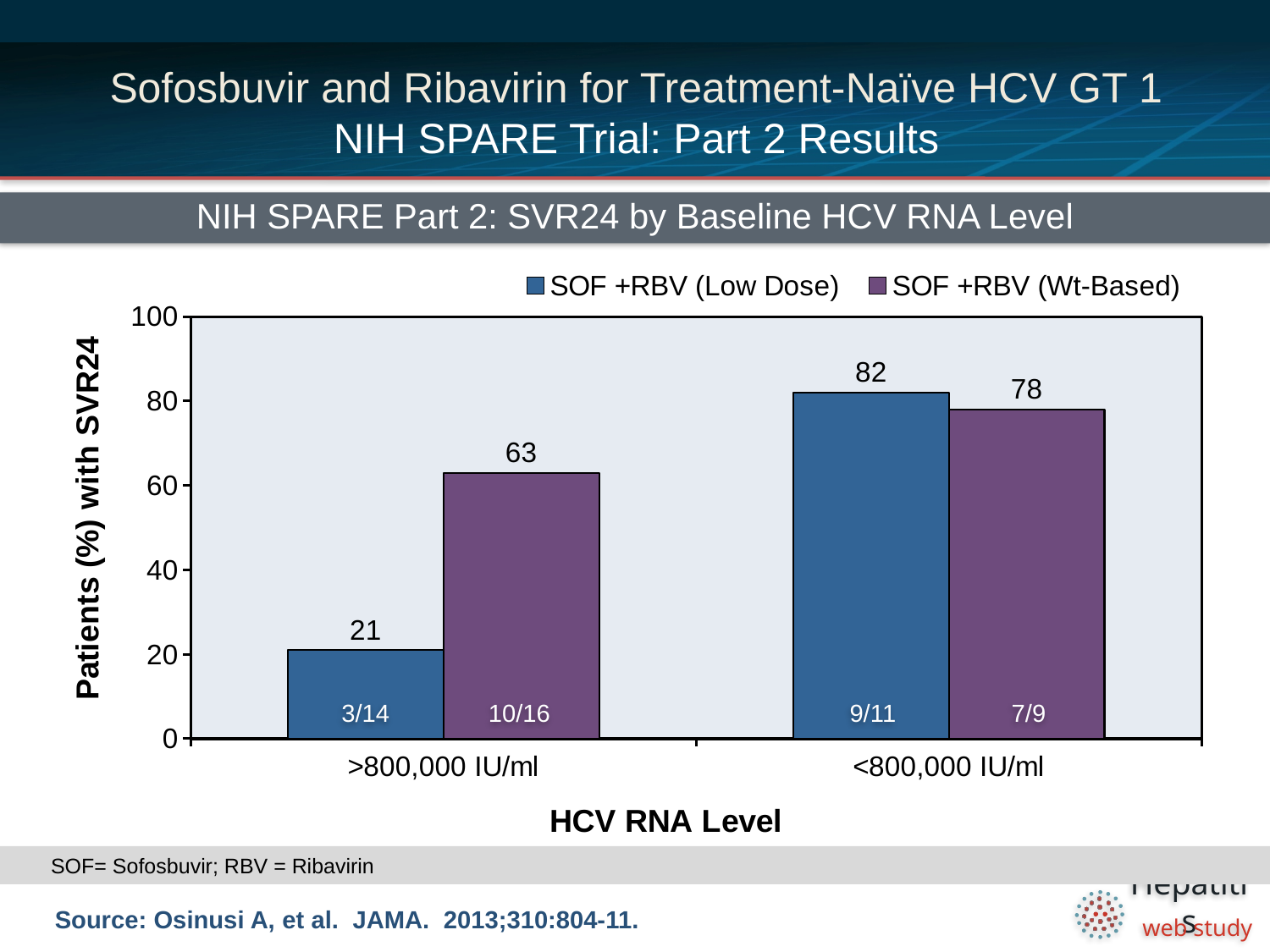
In the <800,000 IU/ml group, which series has the higher SVR24 rate? SOF +RBV (Low Dose) What fraction of patients is shown inside the SOF +RBV (Wt-Based) bar for >800,000 IU/ml? 10/16 How many series does the legend list? 2 Is the SVR24 rate for SOF +RBV (Wt-Based) in the >800,000 IU/ml group greater or less than 60? greater What kind of chart is shown on the slide? Bar chart How many HCV RNA level categories are shown on the x axis? 2 What is the difference in SVR24 rate between SOF +RBV (Wt-Based) and SOF +RBV (Low Dose) in the >800,000 IU/ml group? 42 What is the SVR24 rate for SOF +RBV (Wt-Based) in the <800,000 IU/ml group? 78 Which bar has the highest SVR24 rate on the chart? SOF +RBV (Low Dose), <800,000 IU/ml What is the title of the chart? NIH SPARE Part 2: SVR24 by Baseline HCV RNA Level Which bar has the lowest SVR24 rate on the chart? SOF +RBV (Low Dose), >800,000 IU/ml What is the SVR24 rate for SOF +RBV (Low Dose) in the >800,000 IU/ml group? 21